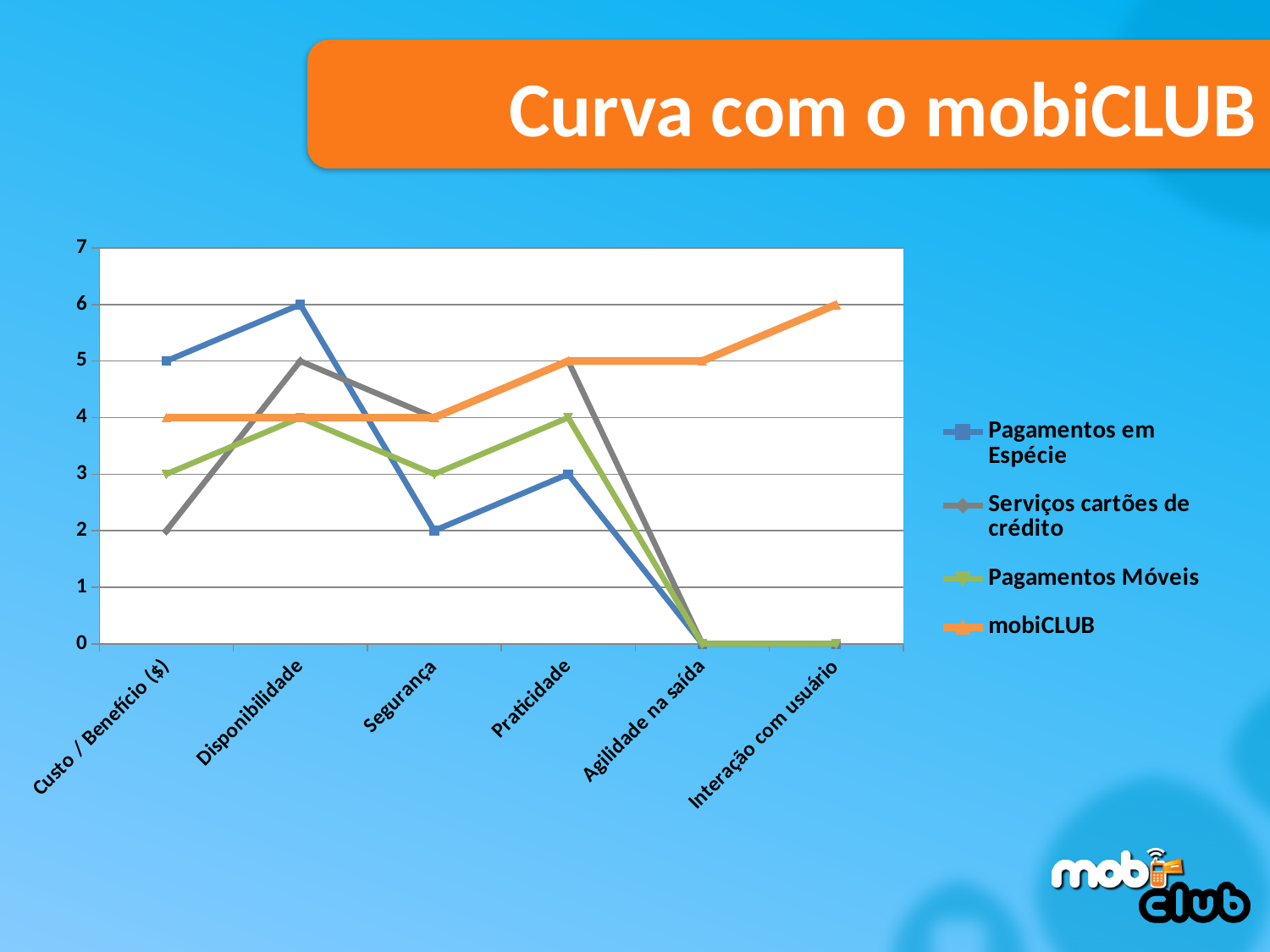
What is the value for Pagamentos em Espécie at Disponibilidade? 6 What kind of chart is shown on the slide? line chart Which series has the highest value at Agilidade na saída? mobiCLUB Does the mobiCLUB series rise or fall from Agilidade na saída to Interação com usuário? rise What is the value for Serviços cartões de crédito at Custo / Benefício ($)? 2 Which series has the lowest value at Custo / Benefício ($)? Serviços cartões de crédito What is the difference between Pagamentos em Espécie and mobiCLUB at Disponibilidade? 2 What is the value for Pagamentos Móveis at Segurança? 3 At Segurança, which is larger: Serviços cartões de crédito or Pagamentos em Espécie? Serviços cartões de crédito What is the value for mobiCLUB at Interação com usuário? 6 How many categories are shown on the x axis? 6 How many series does the legend list? 4